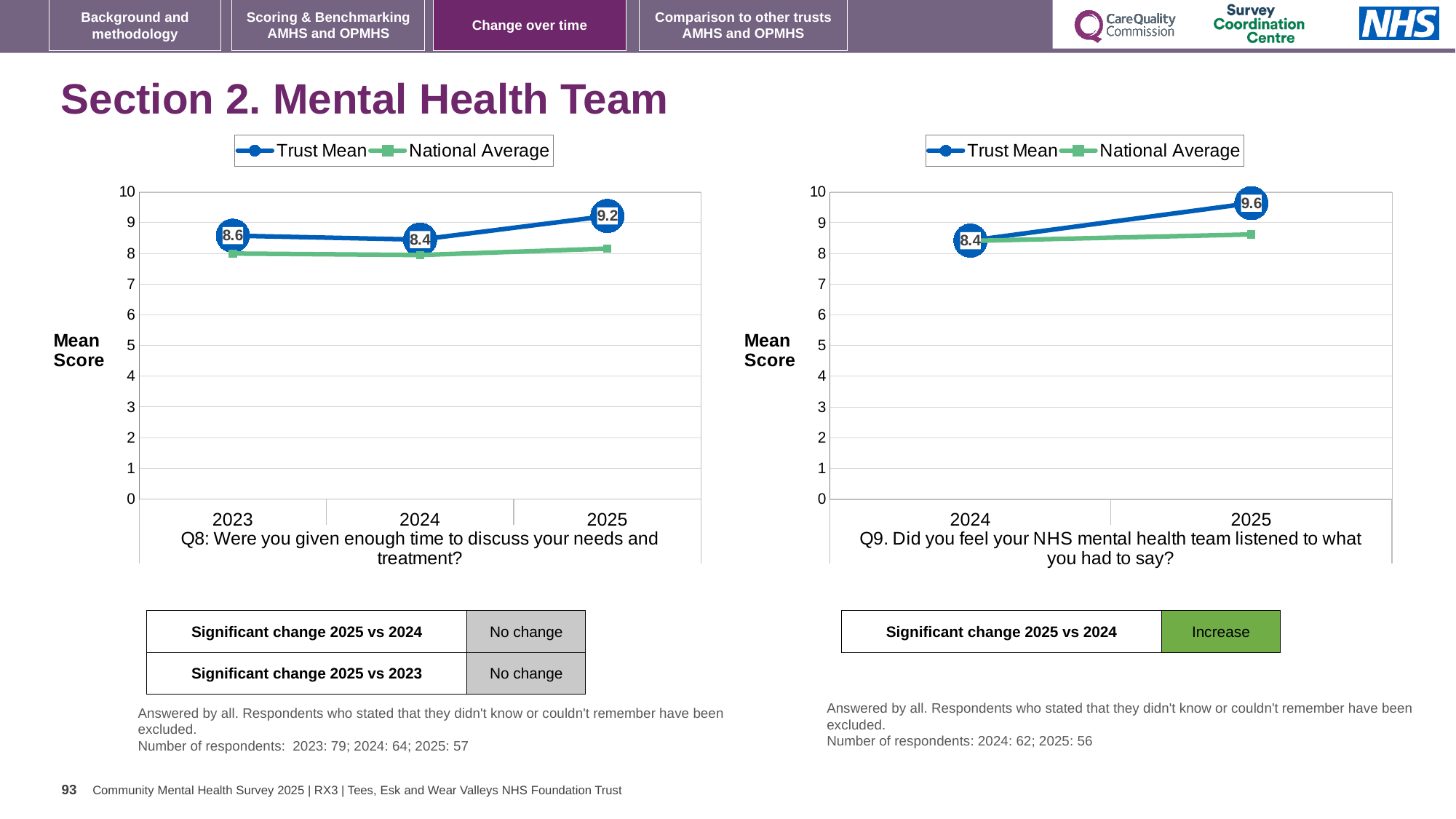
How many years are shown on the x axis of the Q8 chart (left)? 3 In the Q9 chart (right), what is the difference between the Trust Mean for 2025 and 2024? 1.2 In the Q9 chart (right), what is the Trust Mean for 2024? 8.4 In the Q8 chart (left), which year has the highest Trust Mean? 2025 How many series does the legend of the Q9 chart (right) list? 2 In the Q9 chart (right), is the National Average for 2025 greater or less than 9? less In the Q8 chart (left), which year has the lowest Trust Mean? 2024 What kind of chart is used for Q9 (right)? Line chart In the Q9 chart (right), what is the Trust Mean for 2025? 9.6 In the Q8 chart (left), what is the Trust Mean for 2025? 9.2 In the Q8 chart (left), is the Trust Mean for 2025 greater or less than the Trust Mean for 2023? greater In the Q8 chart (left), what is the Trust Mean for 2023? 8.6